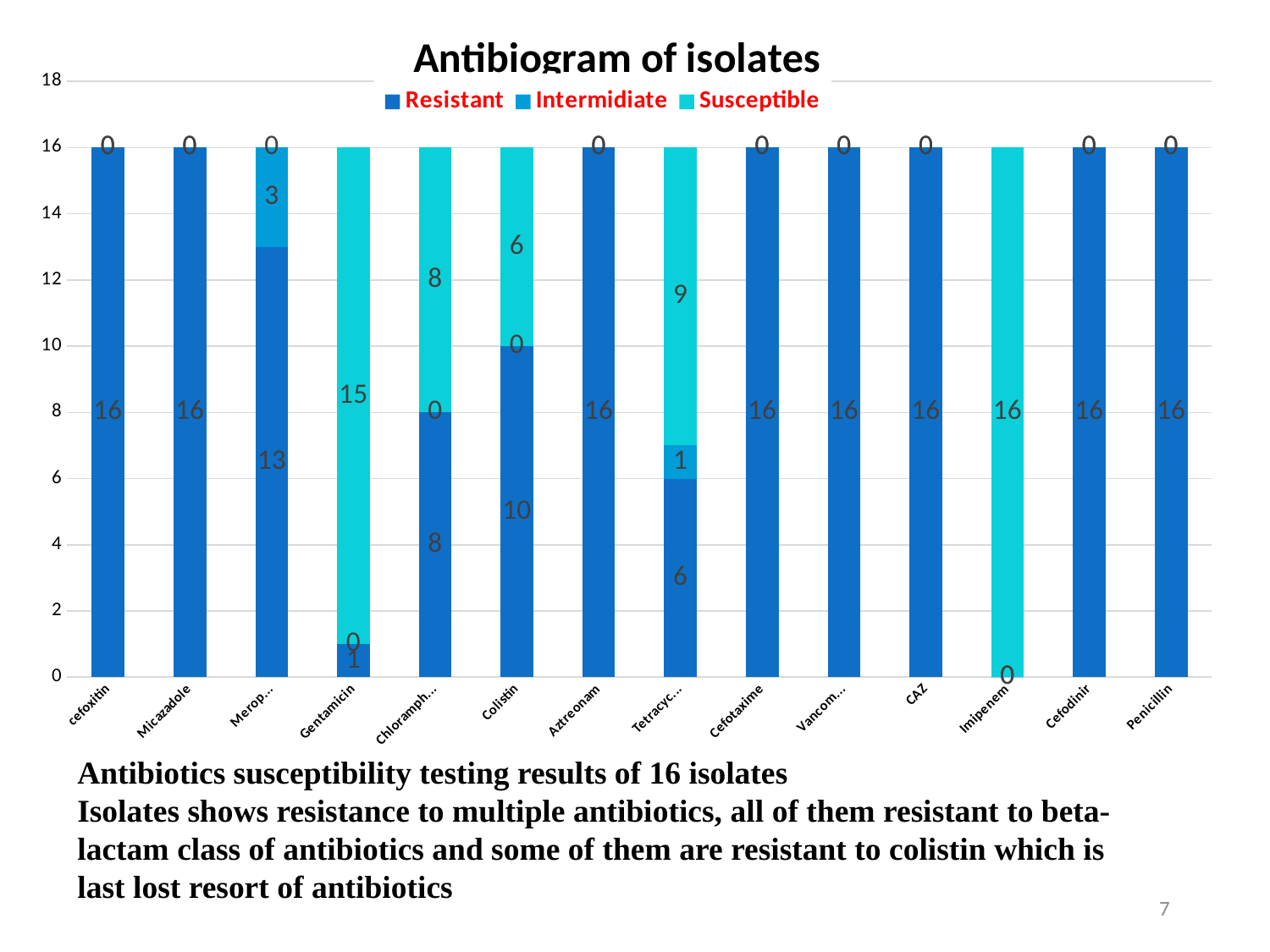
What is the total of the stacked bar for Tetracyc...? 16 What is the difference between the Resistant and Susceptible values for Colistin? 4 What is the Intermidiate value for Tetracyc...? 1 Which is larger: the Susceptible value for Gentamicin or the Susceptible value for Tetracyc...? Gentamicin Which antibiotic has the lowest Resistant value? Imipenem What is the Resistant value for Colistin? 10 How many antibiotics are shown on the x axis? 14 What kind of chart is shown on the slide? Stacked bar chart What is the Resistant value for Imipenem? 0 What is the Susceptible value for Gentamicin? 15 How many series does the legend list? 3 Which antibiotic has the highest Susceptible value? Imipenem